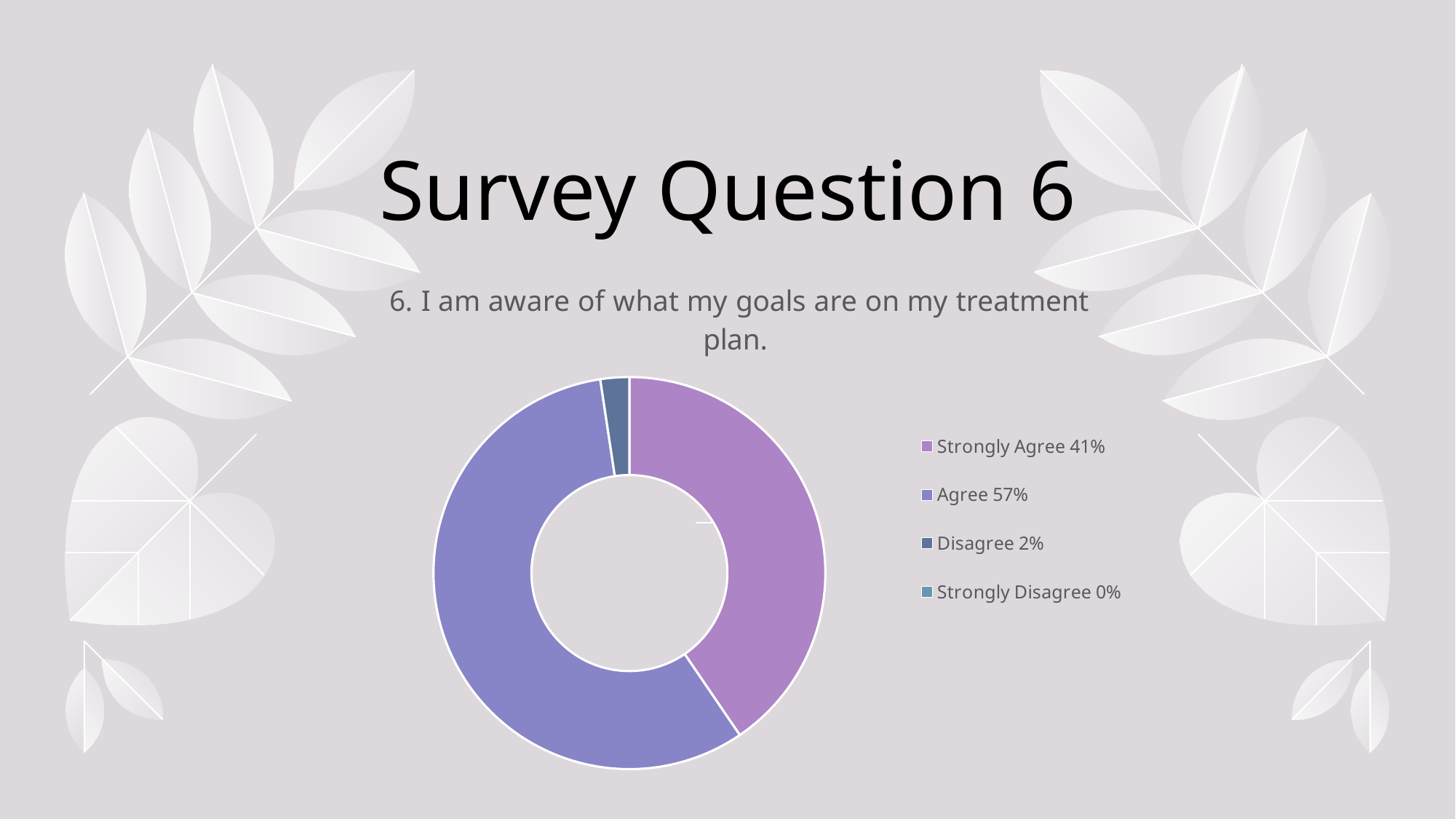
What kind of chart is shown on the slide? Doughnut chart What percentage of respondents answered Agree? 57% What percentage of respondents answered Strongly Agree? 41% How many response categories does the legend list? 4 What percentage of respondents answered Disagree? 2% Which is larger, the share for Strongly Agree or the share for Disagree? Strongly Agree What is the difference in percentage points between Agree and Strongly Agree? 16 Which response category has the smallest share? Strongly Disagree What percentage of respondents answered Strongly Disagree? 0% What survey statement does the chart relate to? I am aware of what my goals are on my treatment plan. What is the combined share of Strongly Agree and Agree? 98% Which response category has the largest share? Agree